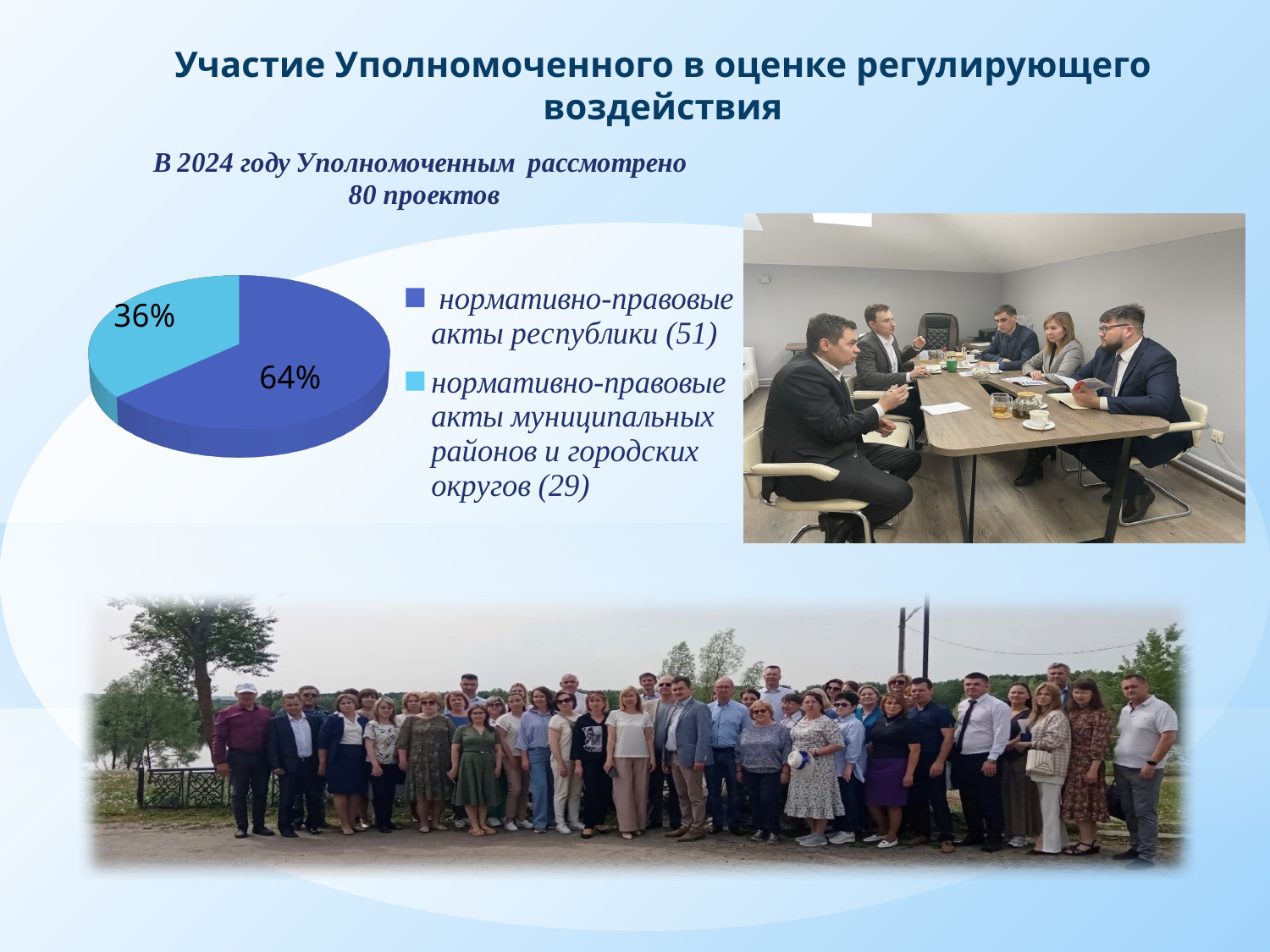
How many slices does the pie chart have? 2 What is the difference in percentage points between the two slices of the pie chart? 28 How many projects does the legend give for нормативно-правовые акты муниципальных районов и городских округов? 29 Which category has the largest share of the pie? нормативно-правовые акты республики Which is larger: the share for акты республики or the share for акты муниципальных районов и городских округов? акты республики What kind of chart is shown on the slide? pie chart What colour is the slice for нормативно-правовые акты муниципальных районов и городских округов? light blue Which category has the smallest share of the pie? нормативно-правовые акты муниципальных районов и городских округов What percentage of the pie is shown for нормативно-правовые акты муниципальных районов и городских округов? 36% What percentage of the pie is shown for нормативно-правовые акты республики? 64% How many projects does the legend give for нормативно-правовые акты республики? 51 According to the text above the chart, how many projects were reviewed in 2024? 80